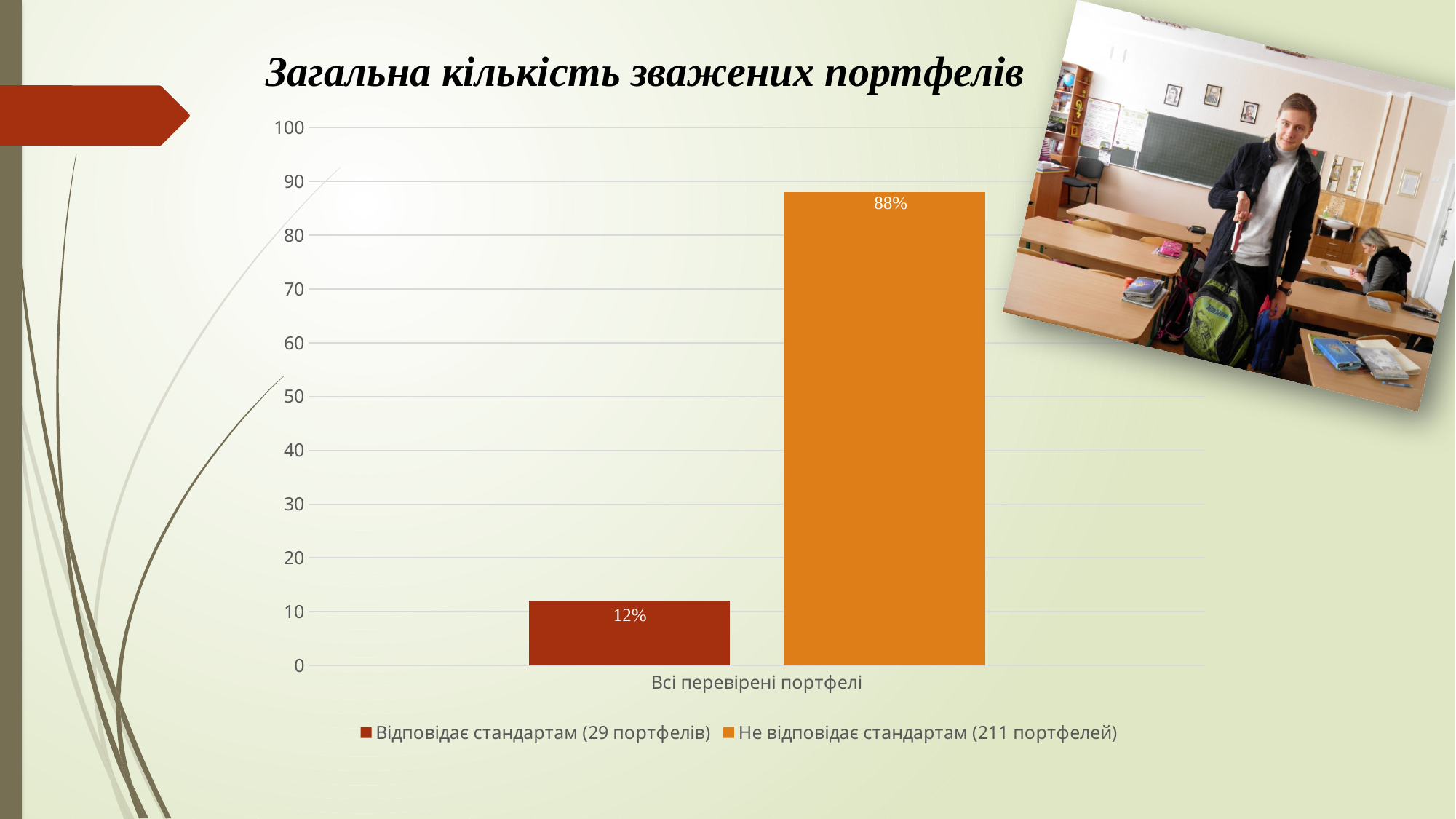
Which series has the higher value? Не відповідає стандартам (211 портфелей) What is the value for 'Відповідає стандартам (29 портфелів)'? 12% How many series does the legend list? 2 What is the value for 'Не відповідає стандартам (211 портфелей)'? 88% What kind of chart is shown on the slide? bar chart What is the category label on the x axis? Всі перевірені портфелі Is the value for 'Відповідає стандартам (29 портфелів)' larger or smaller than the value for 'Не відповідає стандартам (211 портфелей)'? smaller Is the value for 'Не відповідає стандартам (211 портфелей)' greater or less than 80? greater Which series has the lower value? Відповідає стандартам (29 портфелів) What is the title of the chart? Загальна кількість зважених портфелів Is the value for 'Відповідає стандартам (29 портфелів)' greater or less than 20? less What is the difference between the 'Не відповідає стандартам' and 'Відповідає стандартам' values? 76%